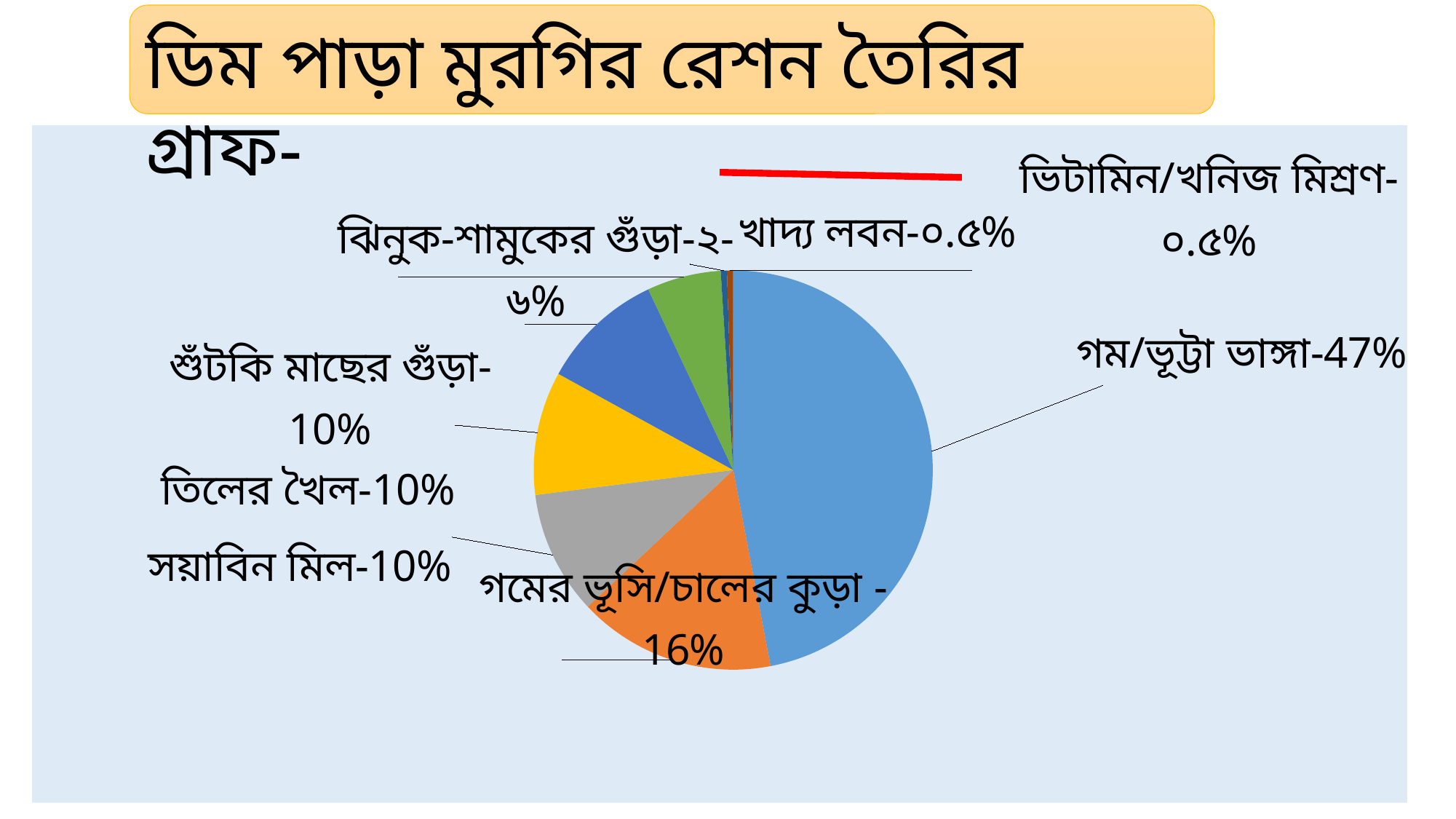
What colour is the largest slice of the pie chart? blue Which ingredient has the largest slice of the pie? গম/ভূট্টা ভাঙ্গা What kind of chart is shown on the slide? pie chart What percentage is labelled for গমের ভূসি/চালের কুড়া? 16% What percentage is labelled for খাদ্য লবন? ০.৫% What percentage is labelled for সয়াবিন মিল? 10% What percentage does the গম/ভূট্টা ভাঙ্গা slice represent? 47% What percentage is labelled for ঝিনুক-শামুকের গুঁড়া? ২-৬% Which is larger, the slice for গমের ভূসি/চালের কুড়া or the slice for তিলের খৈল? গমের ভূসি/চালের কুড়া What is the difference between the percentages for গম/ভূট্টা ভাঙ্গা and গমের ভূসি/চালের কুড়া? 31% How many slices does the pie chart have? 8 What is the title of the slide containing the pie chart? ডিম পাড়া মুরগির রেশন তৈরির গ্রাফ-